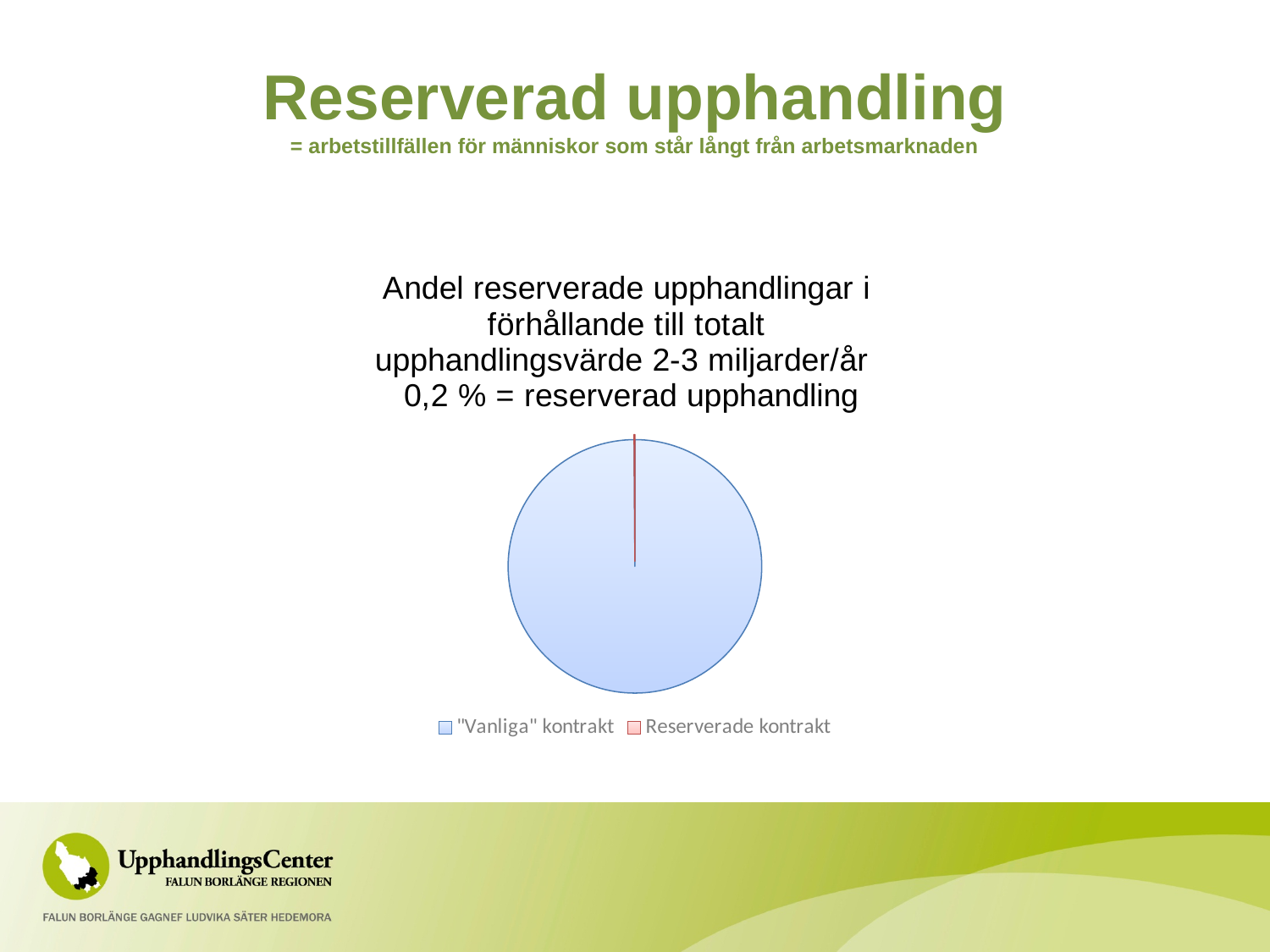
Which is larger in the pie chart, "Vanliga" kontrakt or Reserverade kontrakt? "Vanliga" kontrakt What kind of chart is shown on the slide? pie chart Which category takes up the smallest share of the pie chart? Reserverade kontrakt Is the share of "Vanliga" kontrakt in the pie chart greater or less than 50%? greater Is the share of Reserverade kontrakt in the pie chart greater or less than 50%? less What colour represents Reserverade kontrakt in the pie chart? red According to the chart title, what share of the total procurement value is reserved procurement (Reserverade kontrakt)? 0,2 % How many categories does the pie chart show? 2 What colour represents "Vanliga" kontrakt in the pie chart? light blue How many entries does the legend of the pie chart list? 2 Which category takes up the largest share of the pie chart? "Vanliga" kontrakt